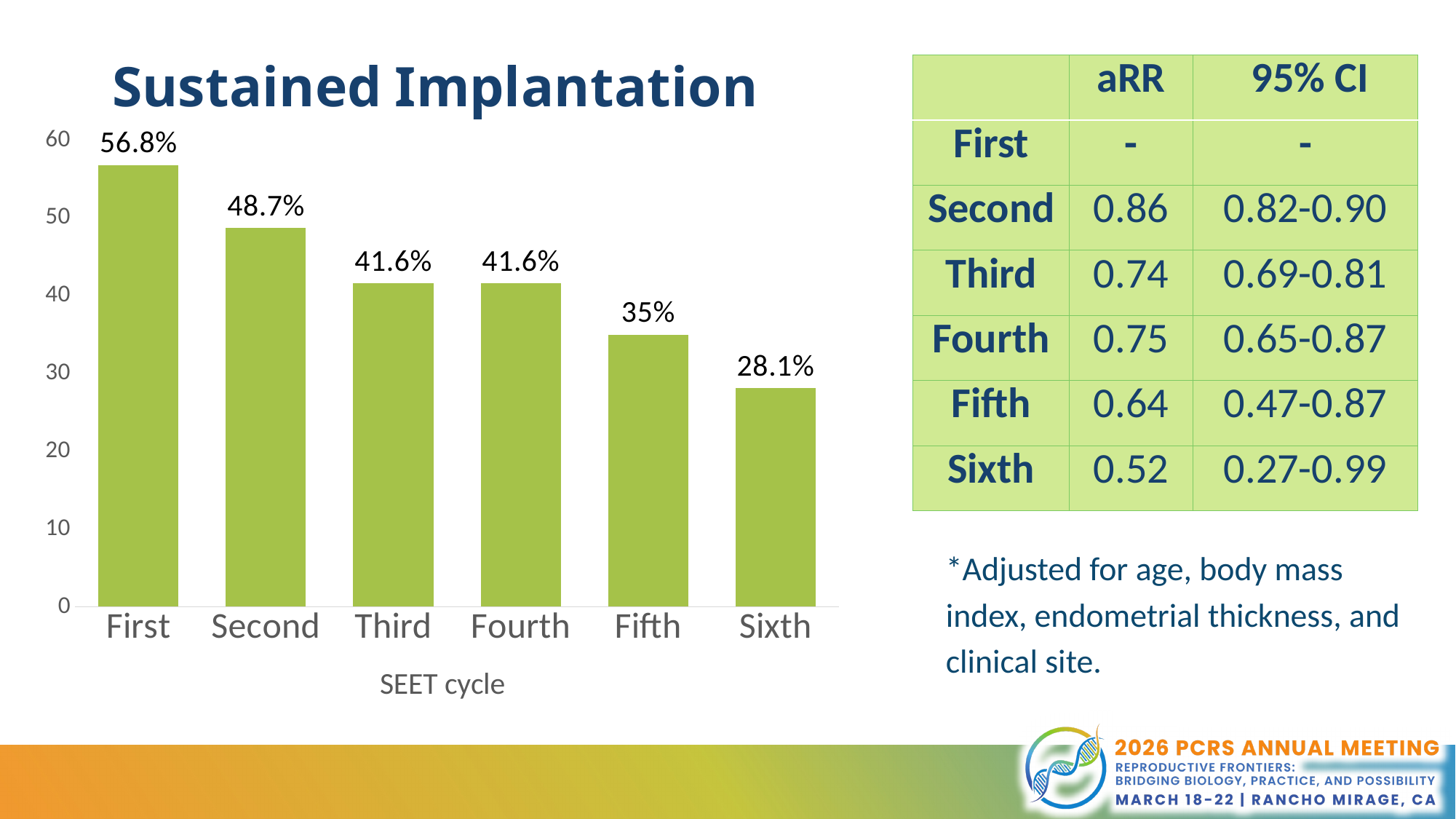
What is the sustained implantation value for the Sixth SEET cycle? 28.1% Do the sustained implantation values rise or fall from the First to the Sixth SEET cycle? Fall Which SEET cycle has the lowest sustained implantation value? Sixth What is the difference between the sustained implantation values for the Fifth and Sixth SEET cycles? 6.9% What is the difference between the sustained implantation values for the First and Second SEET cycles? 8.1% What kind of chart is shown on the slide? Bar chart What is the title of the chart? Sustained Implantation What is the sustained implantation value for the First SEET cycle? 56.8% What is the sustained implantation value for the Fifth SEET cycle? 35% Which SEET cycle has the highest sustained implantation value? First How many SEET cycle categories are shown in the chart? 6 Which has a larger sustained implantation value, the Second or the Fifth SEET cycle? Second